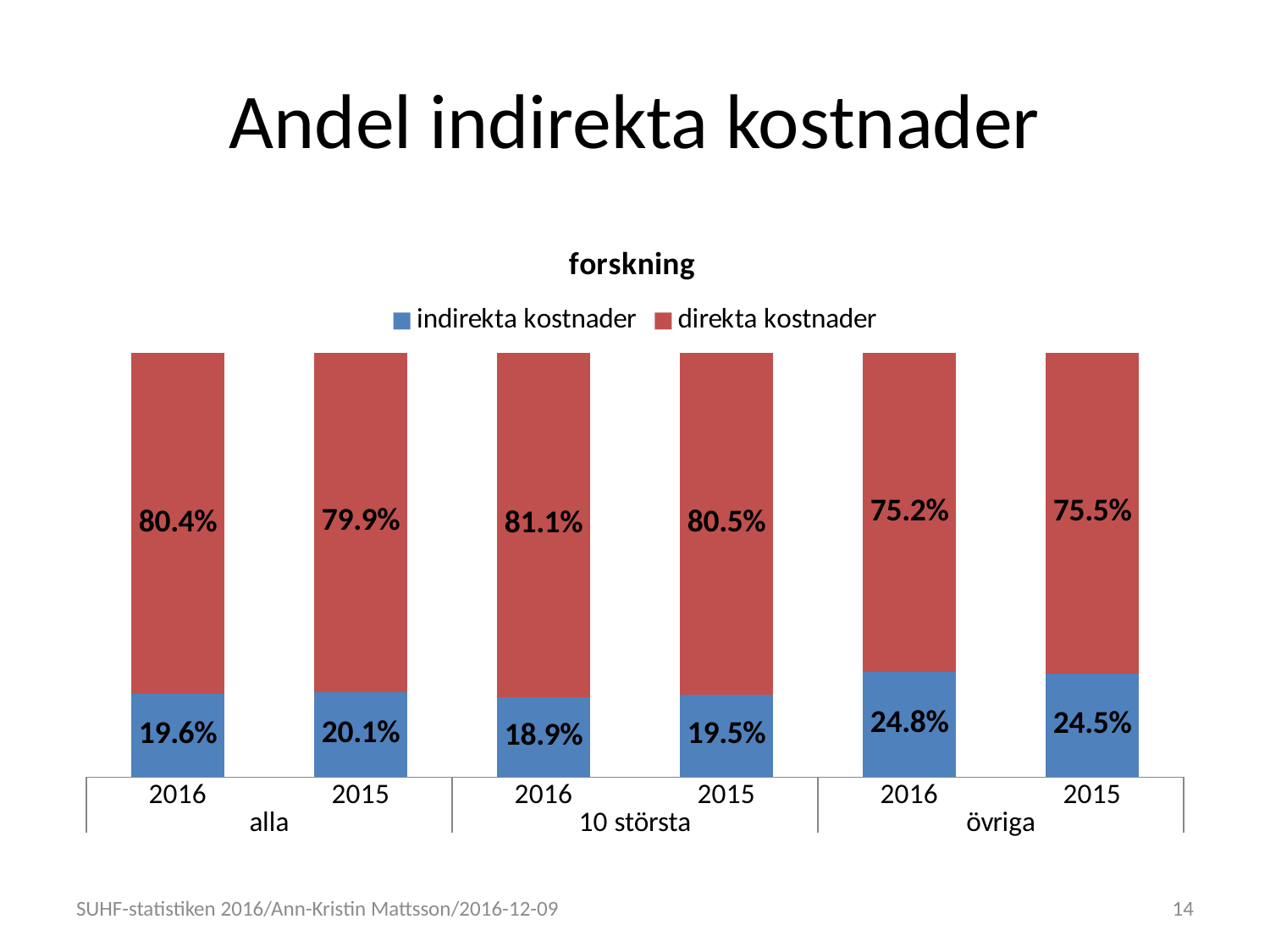
Which bar has the lowest value for indirekta kostnader? 10 största 2016 What is the title of the chart? forskning What is the difference between indirekta kostnader for övriga in 2016 and for alla in 2016? 5.2% How many series does the legend list? 2 What is the value of direkta kostnader for 10 största in 2015? 80.5% What kind of chart is shown on the slide? Stacked bar chart How many bars are shown in the chart? 6 What is the value of indirekta kostnader for alla in 2016? 19.6% Which is larger: direkta kostnader for 10 största in 2016 or for alla in 2016? 10 största 2016 What is the value of indirekta kostnader for övriga in 2016? 24.8% What is the value of direkta kostnader for övriga in 2015? 75.5% Which bar has the highest value for indirekta kostnader? övriga 2016